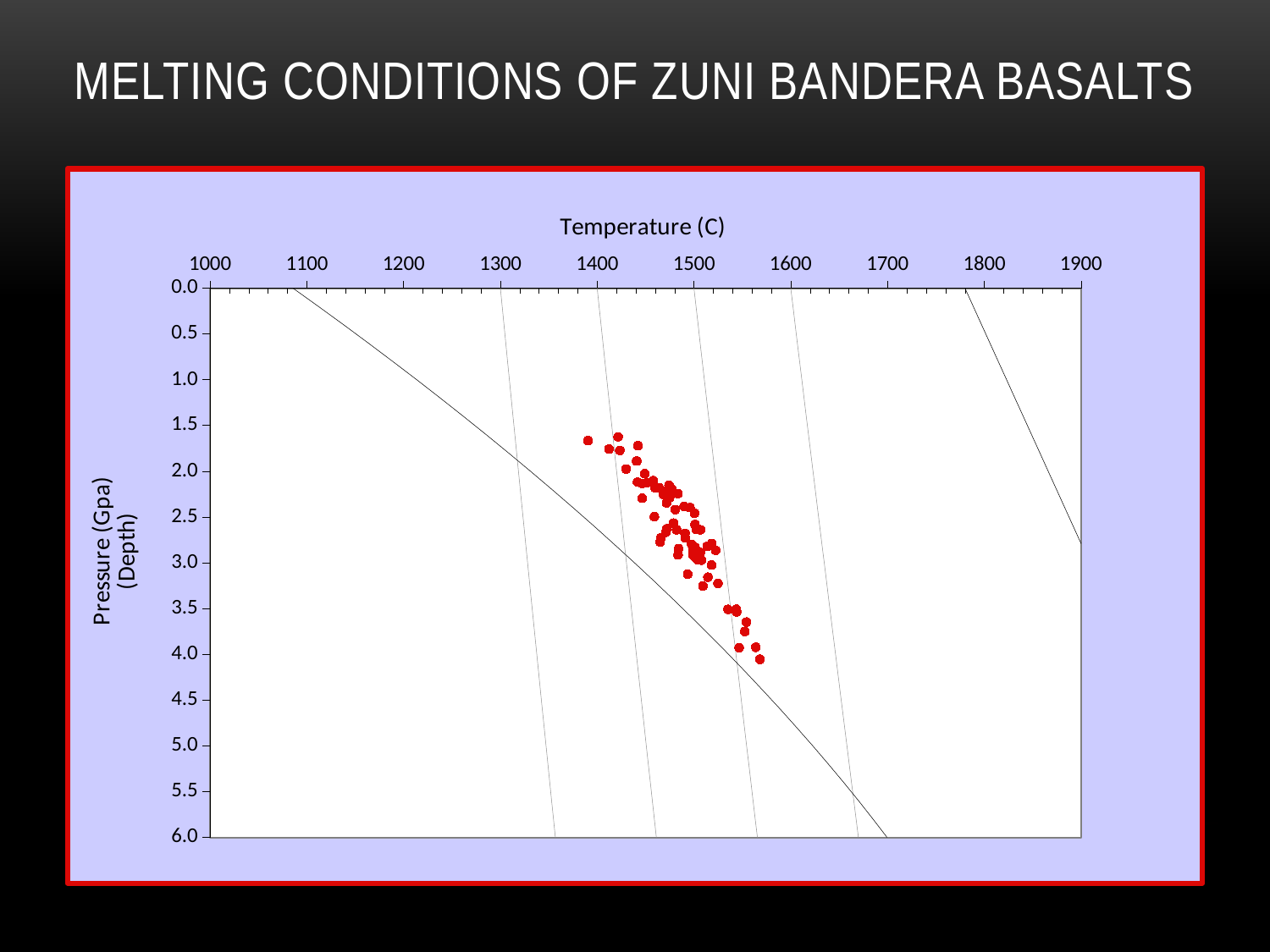
Are all of the red data points at pressures greater or less than 1.5? greater Is the pressure of the red data point with the lowest pressure greater or less than 2.0? less Along the cluster of red data points, does the pressure value increase or decrease as temperature increases? increase What is the title of the y axis of the chart? Pressure (Gpa) (Depth) Is the pressure of the red data point with the highest pressure greater or less than 3.5? greater What is the title of the x axis of the chart? Temperature (C) What kind of chart is shown on the slide? scatter chart